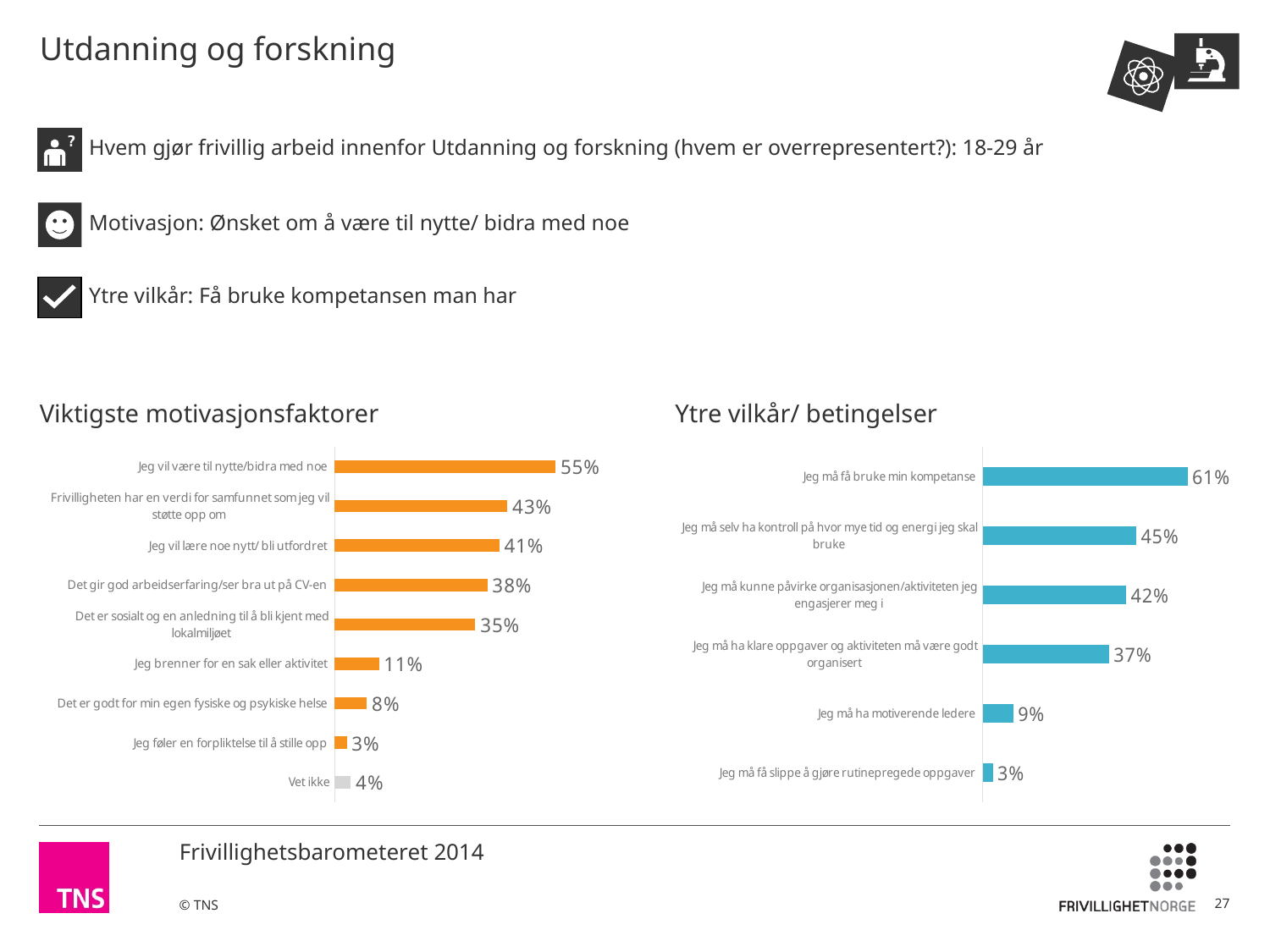
In the 'Ytre vilkår/ betingelser' chart, which category has the highest value? Jeg må få bruke min kompetanse In the 'Viktigste motivasjonsfaktorer' chart, how many categories are shown? 9 In the 'Ytre vilkår/ betingelser' chart, what is the value for 'Jeg må ha motiverende ledere'? 9% In the 'Viktigste motivasjonsfaktorer' chart, which category has the lowest value? Jeg føler en forpliktelse til å stille opp In the 'Viktigste motivasjonsfaktorer' chart, which is larger: 'Jeg brenner for en sak eller aktivitet' or 'Det er godt for min egen fysiske og psykiske helse'? Jeg brenner for en sak eller aktivitet In the 'Ytre vilkår/ betingelser' chart, what is the value for 'Jeg må få bruke min kompetanse'? 61% In the 'Ytre vilkår/ betingelser' chart, how many categories are shown? 6 In the 'Viktigste motivasjonsfaktorer' chart, what is the value for 'Jeg vil være til nytte/bidra med noe'? 55% In the 'Viktigste motivasjonsfaktorer' chart, what is the difference between 'Jeg vil lære noe nytt/ bli utfordret' and 'Det gir god arbeidserfaring/ser bra ut på CV-en'? 3% In the 'Viktigste motivasjonsfaktorer' chart, which bar is coloured grey rather than orange? Vet ikke In the 'Ytre vilkår/ betingelser' chart, what is the difference between 'Jeg må få bruke min kompetanse' and 'Jeg må selv ha kontroll på hvor mye tid og energi jeg skal bruke'? 16% What type of chart is the 'Ytre vilkår/ betingelser' chart? Bar chart